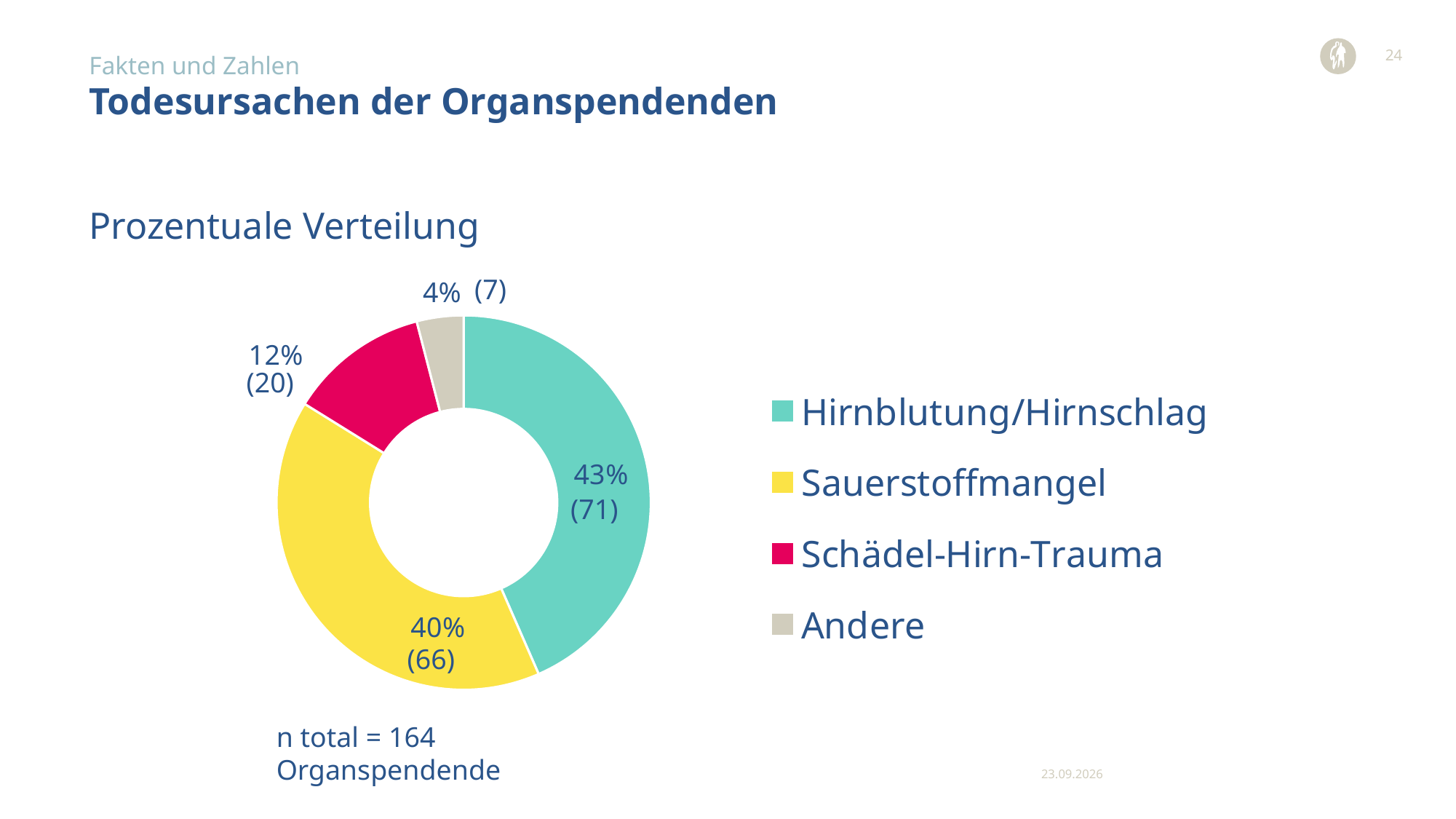
Which category has the largest share of the pie chart? Hirnblutung/Hirnschlag What is the count shown for Sauerstoffmangel? 66 What is the total number of organ donors (n total) stated below the chart? 164 What percentage does Schädel-Hirn-Trauma represent? 12% Which colour represents Sauerstoffmangel in the legend? Yellow What is the difference in count between Hirnblutung/Hirnschlag and Sauerstoffmangel? 5 What is the count shown for Andere? 7 What percentage of the pie chart does Hirnblutung/Hirnschlag account for? 43% Which has a larger share, Schädel-Hirn-Trauma or Andere? Schädel-Hirn-Trauma What kind of chart is shown on the slide? Pie chart (donut) Which category has the smallest share of the pie chart? Andere How many categories are shown in the pie chart? 4